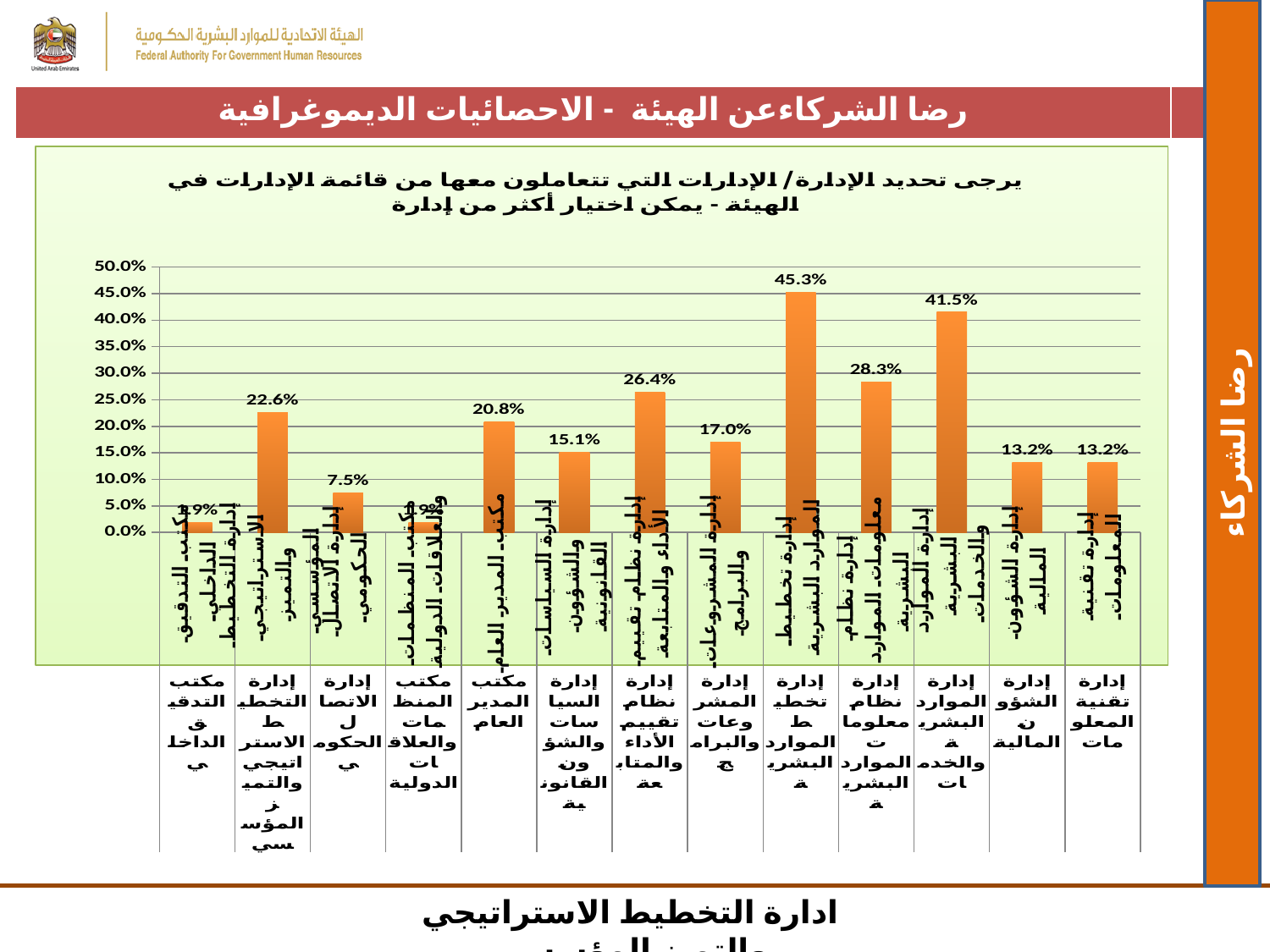
What is the value for إدارة تخطيط الموارد البشرية? 45.3% What kind of chart is shown on the slide? bar chart What is the value for إدارة الموارد البشرية والخدمات? 41.5% What is the value for إدارة التخطيط الاستراتيجي والتميز المؤسسي? 22.6% What is the value for إدارة نظام تقييم الأداء والمتابعة? 26.4% What is the value for إدارة الاتصال الحكومي? 7.5% Which is larger, the value for مكتب المدير العام or the value for إدارة السياسات والشؤون القانونية? مكتب المدير العام Which department has the highest value? إدارة تخطيط الموارد البشرية What is the highest value shown on the vertical axis? 50.0% What is the difference between the values for إدارة تخطيط الموارد البشرية and إدارة الموارد البشرية والخدمات? 3.8% Is the value for مكتب المنظمات والعلاقات الدولية greater or less than 5.0%? less How many departments are shown on the x axis? 13